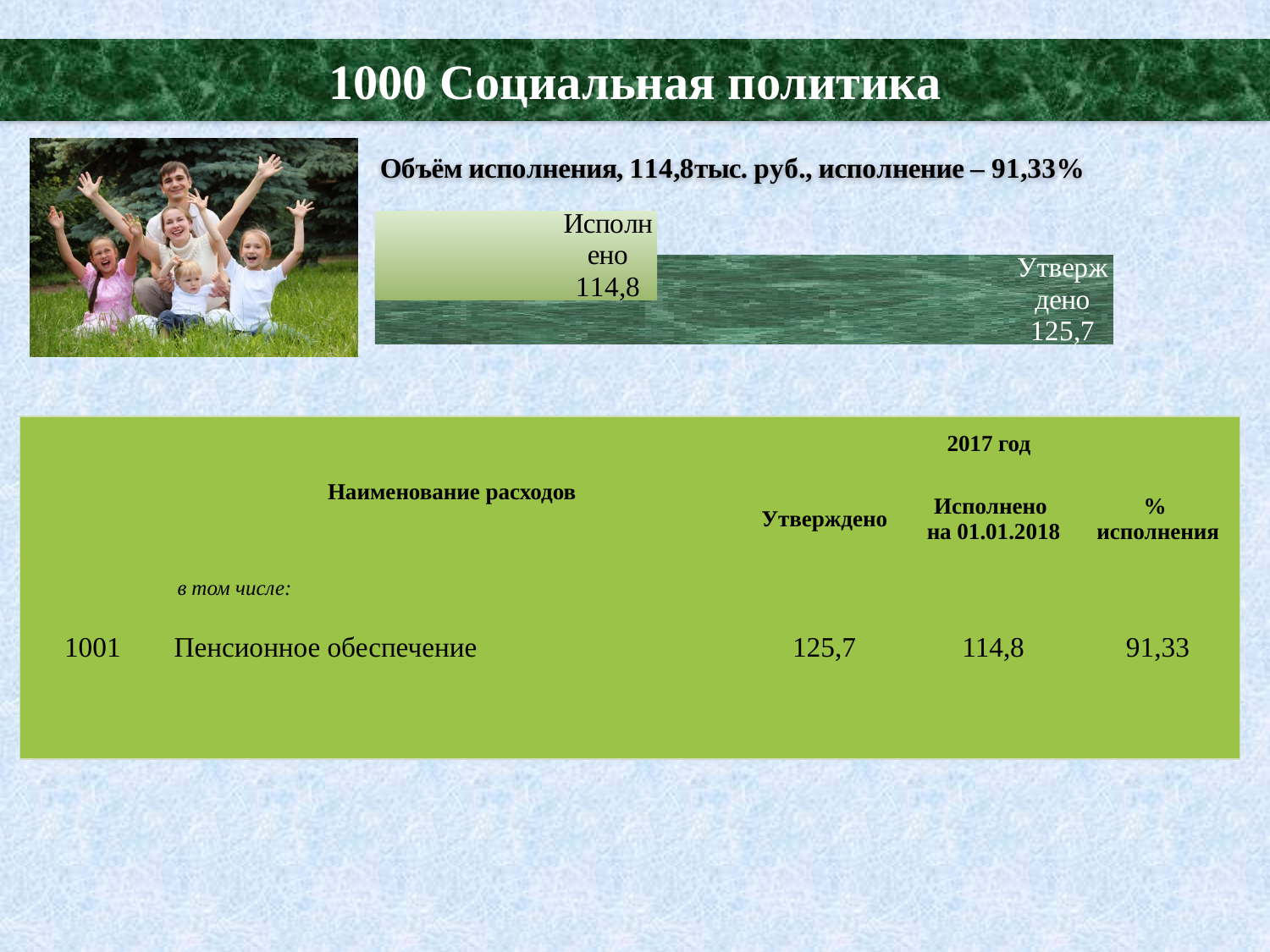
What is the difference between the "Утверждено" value and the "Исполнено" value in the chart? 10,9 Which bar in the chart is drawn in the lighter green colour? Исполнено Which bar in the chart has the lower value? Исполнено What value is shown for the "Исполнено" bar in the chart? 114,8 What value is shown for the "Утверждено" bar in the chart? 125,7 What percentage of execution (исполнение) is stated in the text above the chart? 91,33% How many bars are plotted in the chart? 2 Is the value for "Исполнено" larger or smaller than the value for "Утверждено" in the chart? smaller Which bar in the chart has the higher value? Утверждено What kind of chart is shown on the slide? bar chart